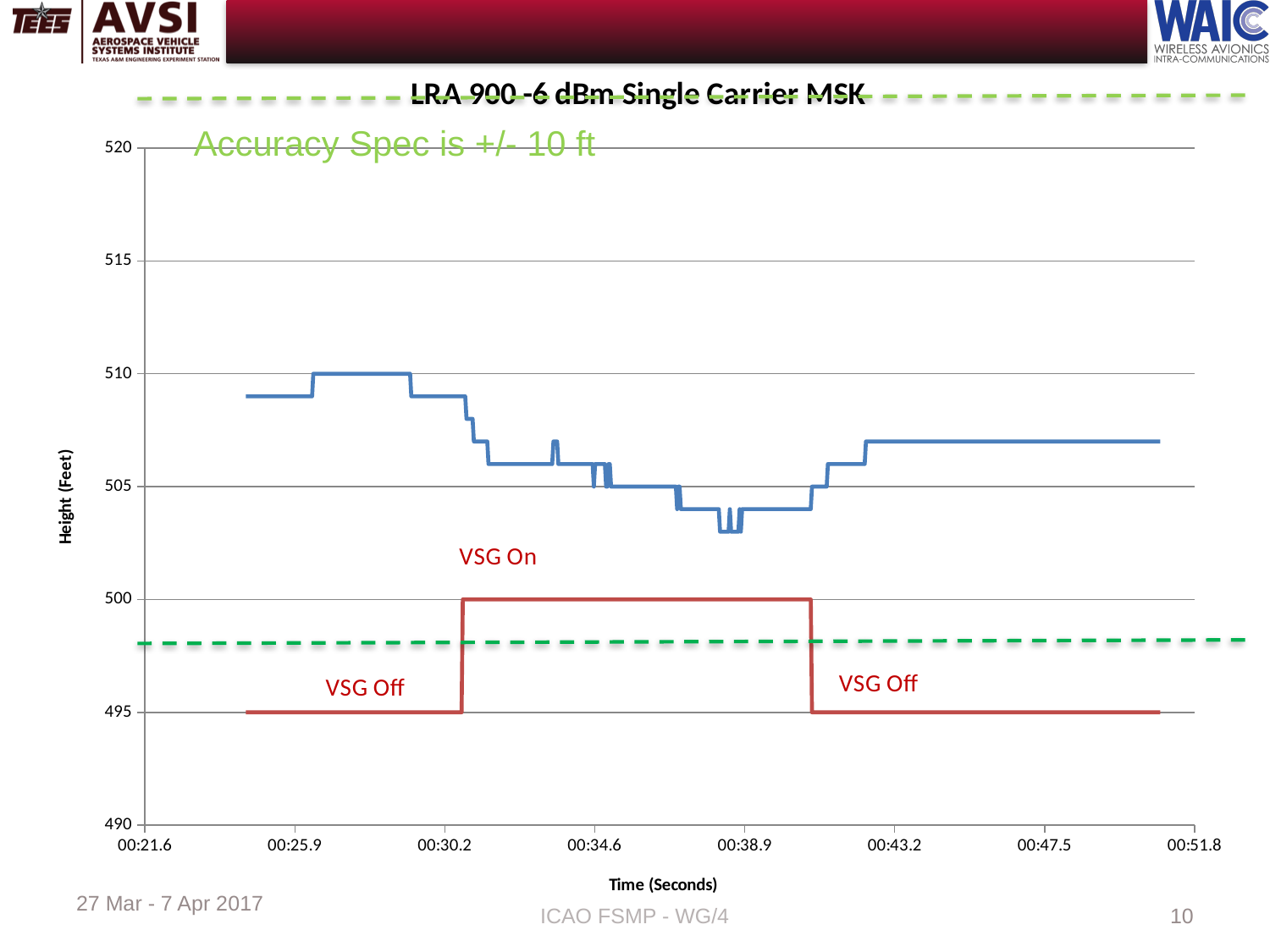
Does the blue line rise or fall between 00:25.9 and 00:38.9? fall Which is higher: the blue line at 00:47.5 or the red line at 00:47.5? the blue line Is the green dashed line greater or less than 500? less What height value does the red line sit at while the VSG is off? 495 According to the annotation on the chart, what is the accuracy spec? +/- 10 ft Is the blue line's height at 00:38.9 greater or less than 505? less What height value does the red line sit at while the VSG is on? 500 What kind of chart is shown on the slide? line chart How many time tick labels are shown on the x axis? 8 What is the title of the chart? LRA 900 -6 dBm Single Carrier MSK What is the highest height reached by the blue line? 510 Is the blue line's height at 00:25.9 greater or less than 505? greater